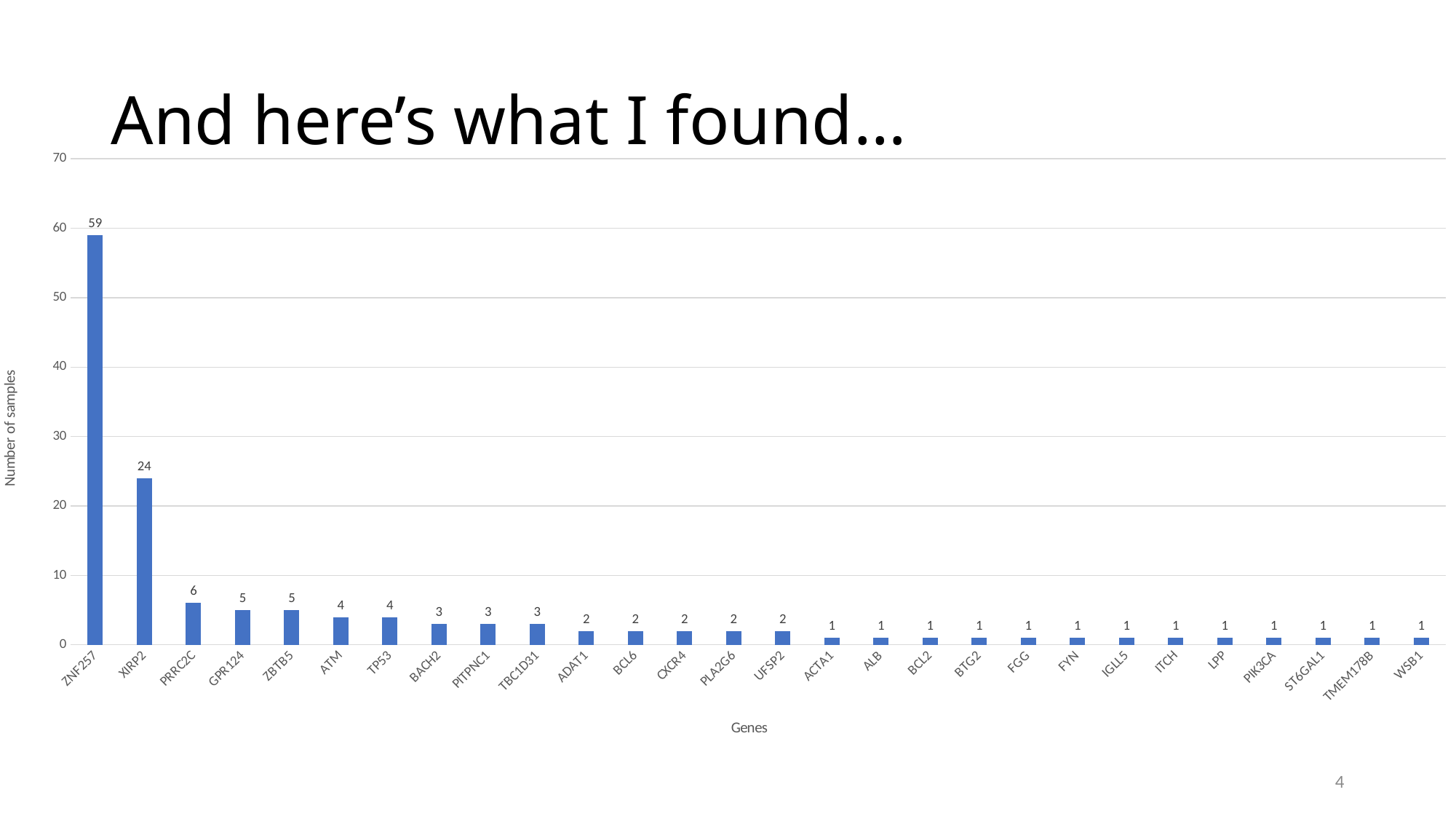
What kind of chart is shown on the slide? Bar chart What is the number of samples for TP53? 4 Which has more samples, GPR124 or ATM? GPR124 Is the value for XIRP2 greater or less than 20? greater What is the number of samples for PRRC2C? 6 What is the number of samples for ZNF257? 59 What is the difference in number of samples between ZNF257 and XIRP2? 35 Do the values rise or fall moving from left to right along the x axis? Fall Which gene has the highest number of samples? ZNF257 How many genes are shown on the x axis? 28 What is the number of samples for XIRP2? 24 What is the label of the y axis? Number of samples